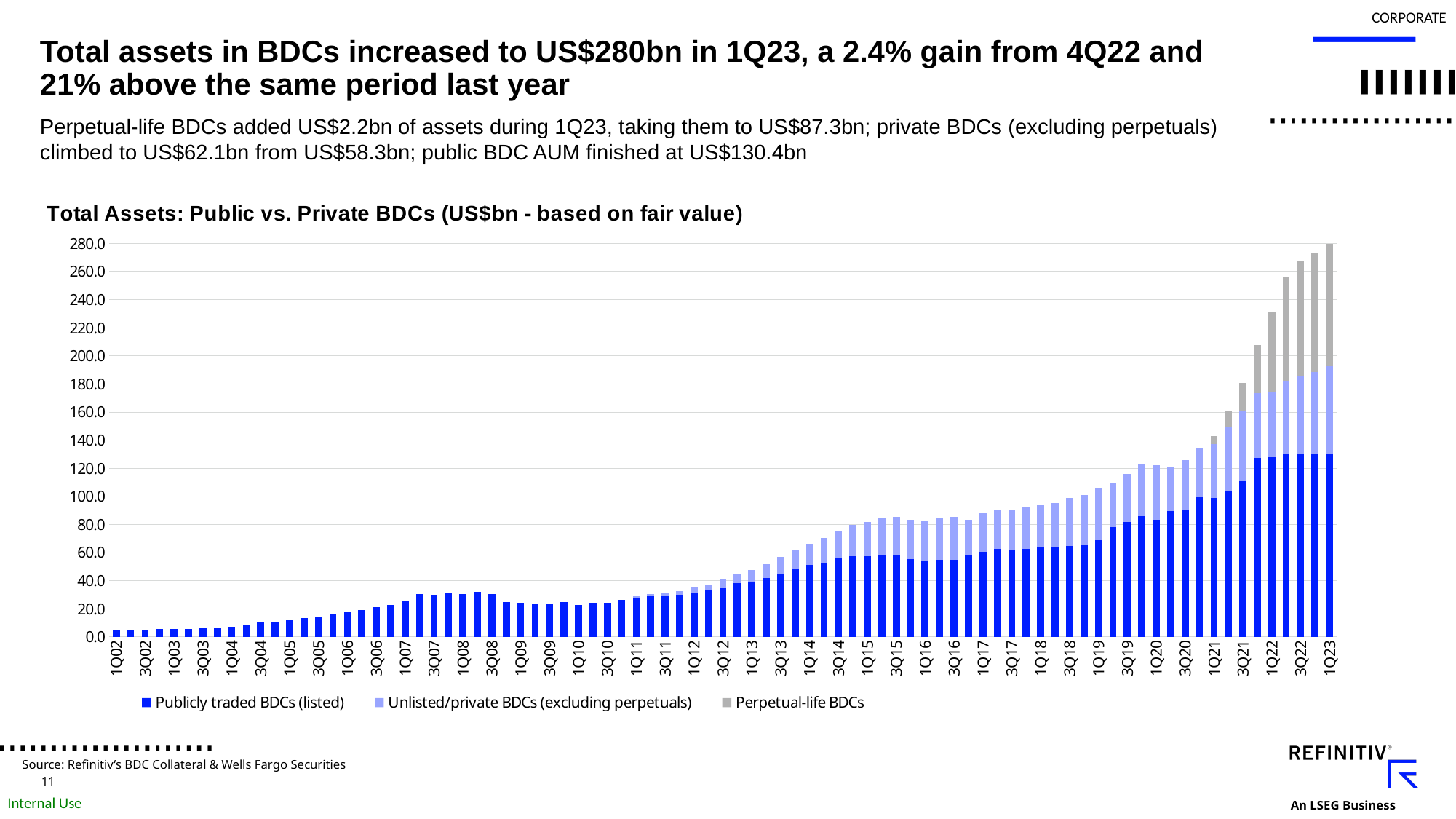
Do total assets generally rise or fall from 1Q02 to 1Q23? Rise Is the Publicly traded BDCs (listed) value for 1Q23 greater or less than 120.0? greater Is the total bar for 1Q15 greater or less than 100.0? less How many series does the legend list? 3 Which quarter has the highest total bar? 1Q23 Is the total bar for 1Q20 greater or less than 100.0? greater Which is larger, the Publicly traded BDCs (listed) value in 1Q08 or in 1Q10? 1Q08 What is the title of the chart? Total Assets: Public vs. Private BDCs (US$bn - based on fair value) Which series is shown in grey in the chart? Perpetual-life BDCs What kind of chart is shown on the slide? Stacked bar chart What is the total of the stacked bar for 1Q23? 280.0